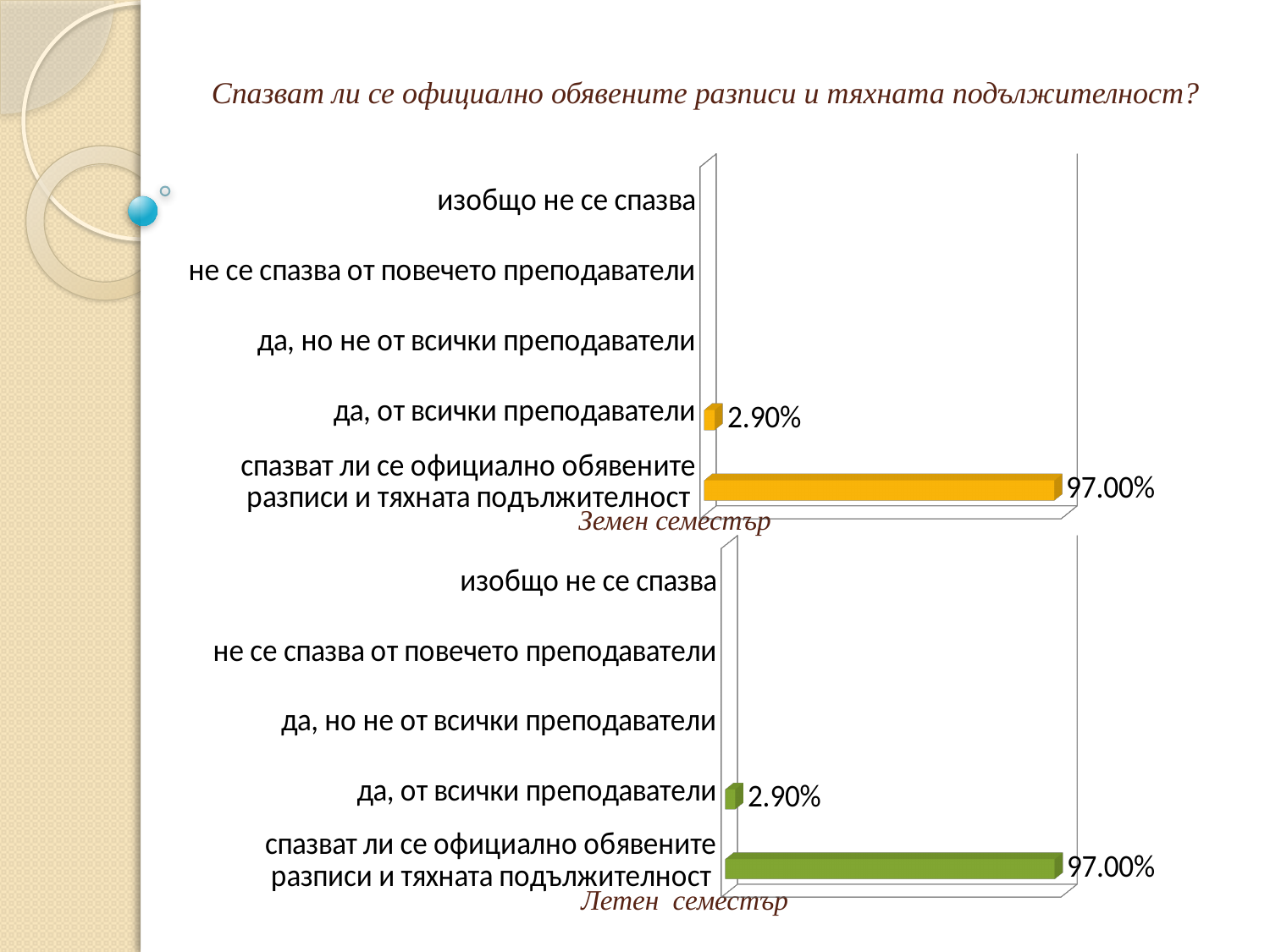
In the chart labelled "Земен семестър", which category has the highest value? спазват ли се официално обявените разписи и тяхната подължителност In the chart labelled "Земен семестър", what is the value for "да, от всички преподаватели"? 2.90% What kind of chart is the chart labelled "Летен семестър"? Bar chart In the chart labelled "Летен семестър", which is larger: the value for "да, от всички преподаватели" or the value for "спазват ли се официално обявените разписи и тяхната подължителност"? спазват ли се официално обявените разписи и тяхната подължителност In the chart labelled "Летен семестър", what is the value for "да, от всички преподаватели"? 2.90% In the chart labelled "Летен семестър", which category has the highest value? спазват ли се официално обявените разписи и тяхната подължителност What colour are the bars in the chart labelled "Летен семестър"? Green In the chart labelled "Земен семестър", what is the value for "спазват ли се официално обявените разписи и тяхната подължителност"? 97.00% In the chart labelled "Земен семестър", what is the difference between the values for "спазват ли се официално обявените разписи и тяхната подължителност" and "да, от всички преподаватели"? 94.10% How many categories are listed on the axis of the chart labelled "Земен семестър"? 5 What is the title at the top of the slide? Спазват ли се официално обявените разписи и тяхната подължителност? In the chart labelled "Летен семестър", what is the value for "спазват ли се официално обявените разписи и тяхната подължителност"? 97.00%